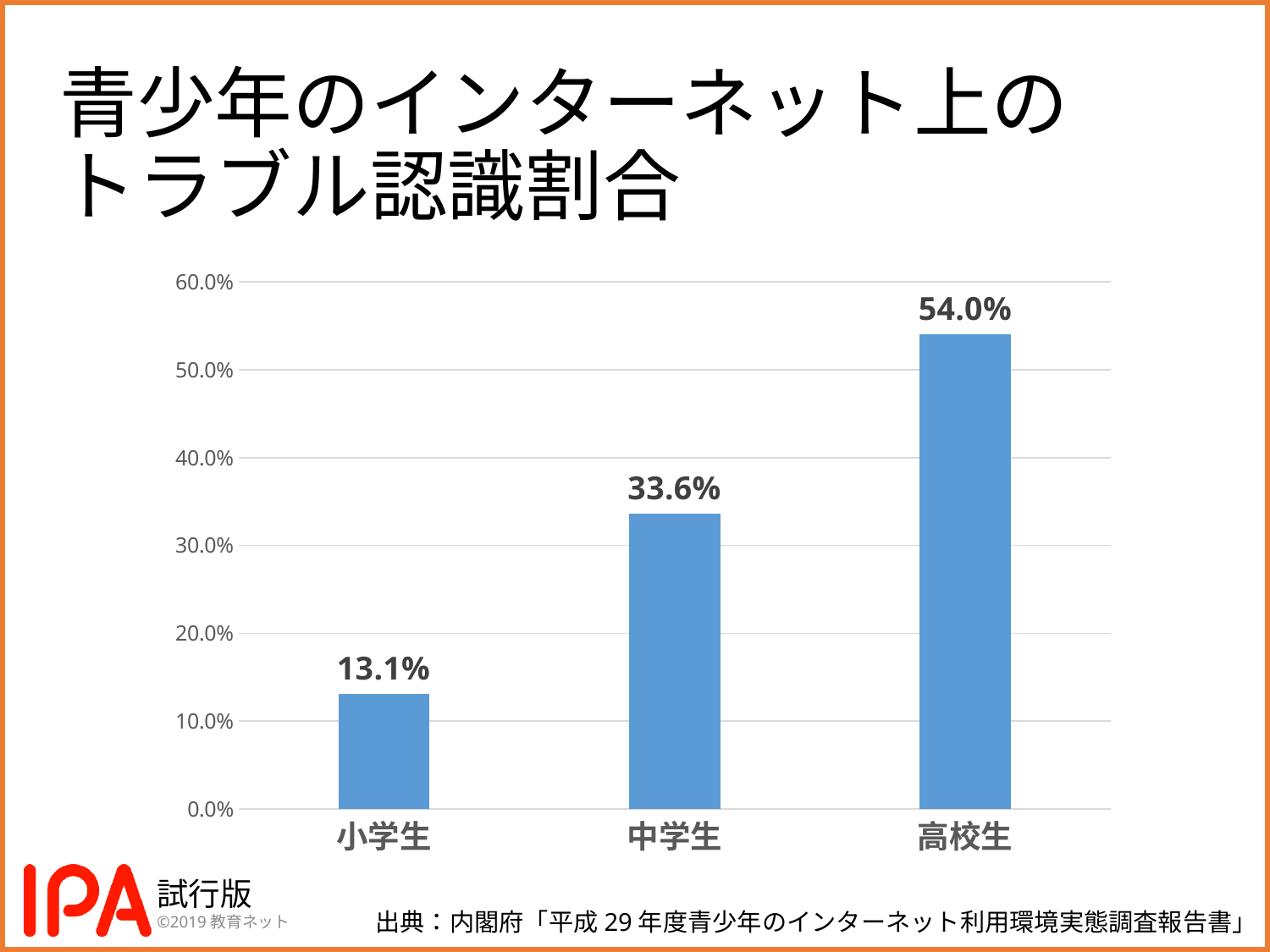
Which is larger, the value for 中学生 or the value for 小学生? 中学生 What kind of chart is shown on the slide? bar chart What is the value for 高校生? 54.0% What is the value for 中学生? 33.6% Is the value for 高校生 greater or less than 50.0%? greater What is the difference between the values for 高校生 and 中学生? 20.4% Do the values rise or fall from 小学生 to 高校生 along the x axis? rise How many categories are shown on the x axis? 3 Which category has the lowest value? 小学生 What is the value for 小学生? 13.1% What is the difference between the values for 中学生 and 小学生? 20.5% Which category has the highest value? 高校生